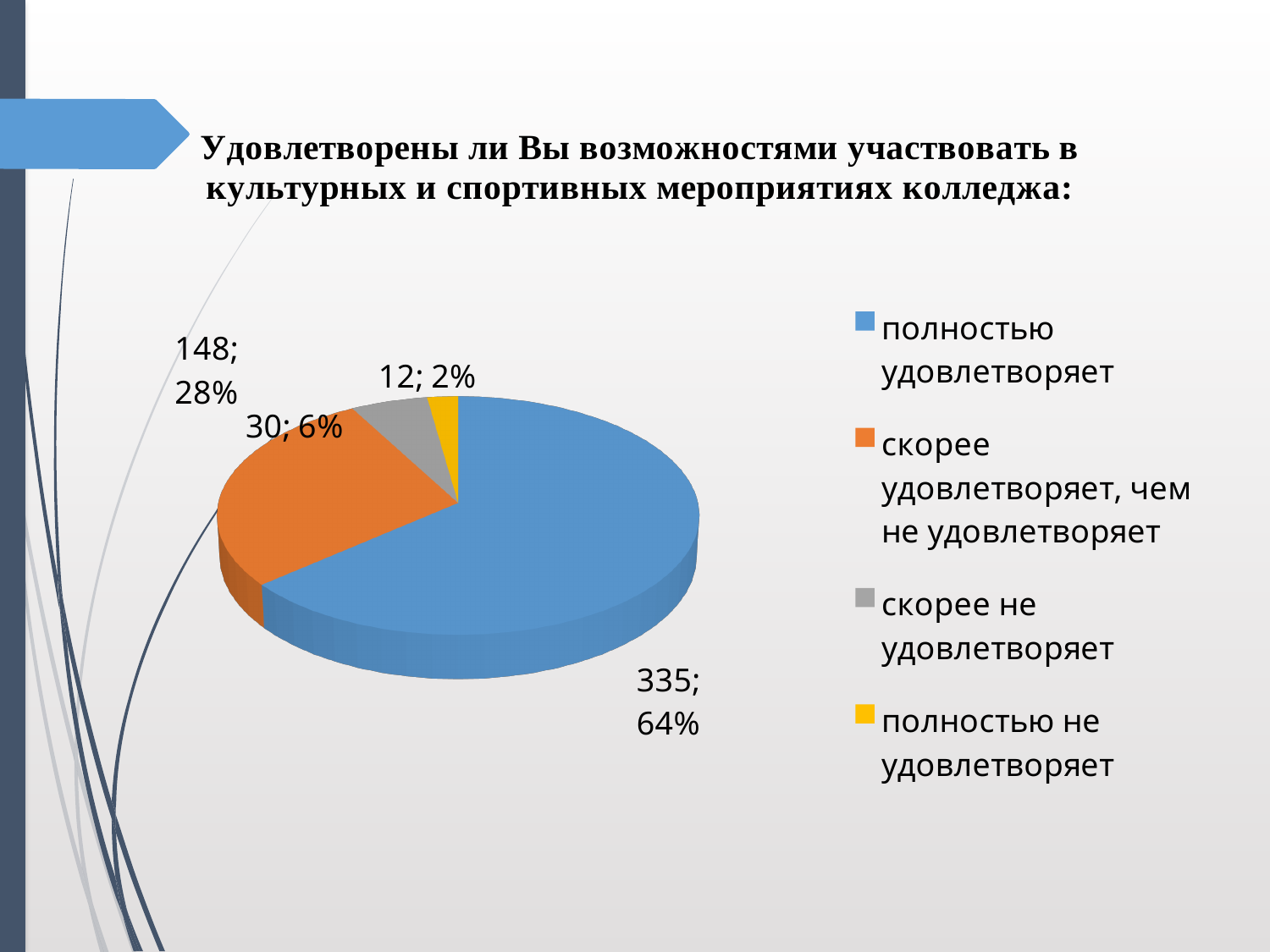
Which category has the largest slice? полностью удовлетворяет What is the value for "полностью не удовлетворяет"? 12 How many entries does the legend list? 4 Which category has the smallest slice? полностью не удовлетворяет What kind of chart is shown on the slide? pie chart What is the value for "скорее удовлетворяет, чем не удовлетворяет"? 148 What is the difference between the values for "полностью удовлетворяет" and "скорее удовлетворяет, чем не удовлетворяет"? 187 What is the value for "скорее не удовлетворяет"? 30 What share of the pie does "полностью удовлетворяет" take? 64% What is the value for "полностью удовлетворяет"? 335 How many slices does the pie chart have? 4 What share of the pie does "скорее не удовлетворяет" take? 6%